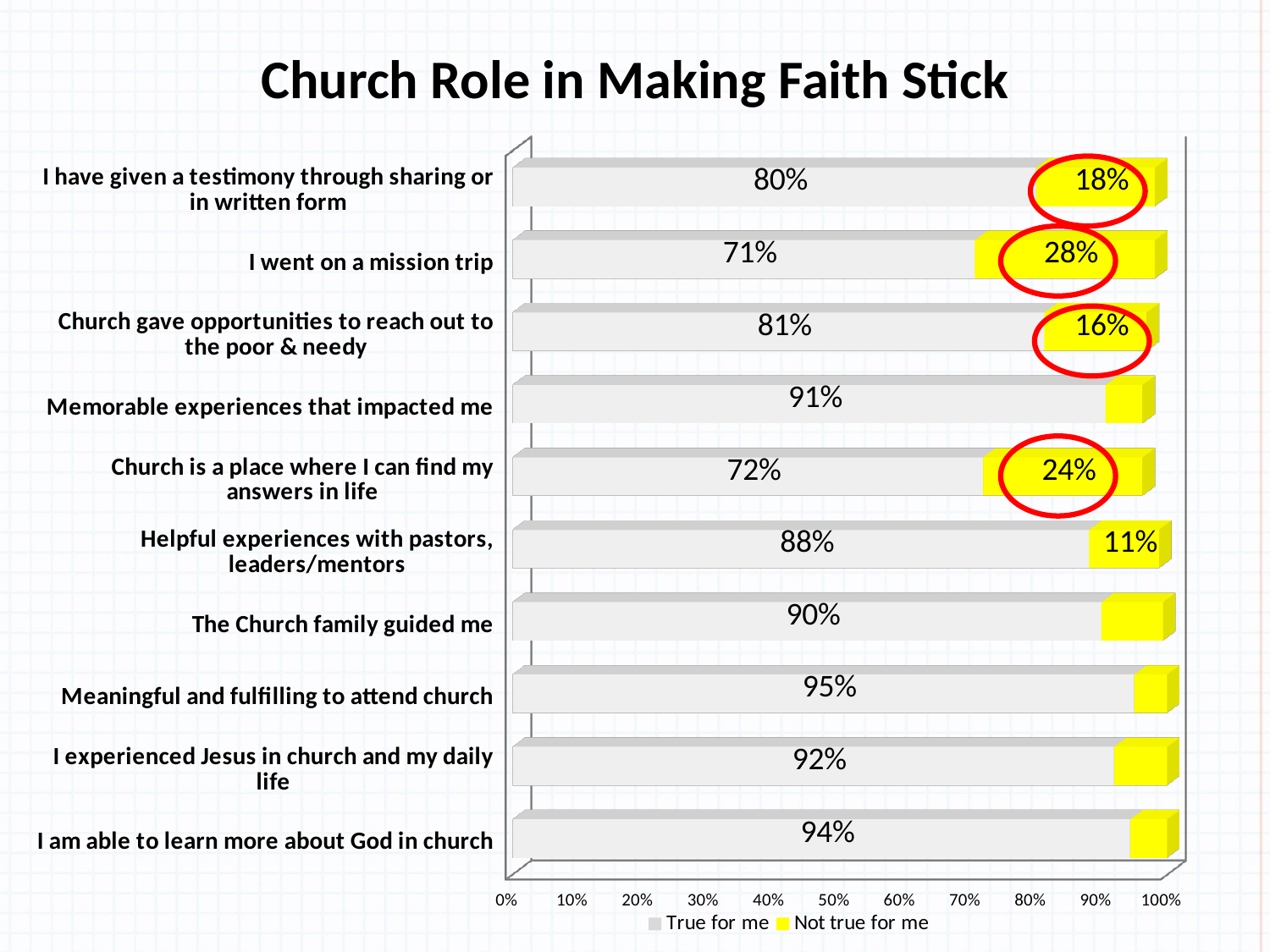
How many categories are shown on the chart? 10 Which category has the highest "Not true for me" value? I went on a mission trip Is the "True for me" value for "I have given a testimony through sharing or in written form" greater or less than 70%? greater What is the "True for me" value for "Helpful experiences with pastors, leaders/mentors"? 88% What is the "Not true for me" value for "Church is a place where I can find my answers in life"? 24% What is the total of the stacked bar for "I have given a testimony through sharing or in written form"? 98% Which category has the highest "True for me" value? Meaningful and fulfilling to attend church What is the "True for me" value for "I went on a mission trip"? 71% How many series does the legend list? 2 Which has a larger "True for me" value: "I experienced Jesus in church and my daily life" or "Helpful experiences with pastors, leaders/mentors"? I experienced Jesus in church and my daily life What is the difference between the "True for me" values for "Meaningful and fulfilling to attend church" and "I went on a mission trip"? 24 percentage points Which category has the lowest "True for me" value? I went on a mission trip